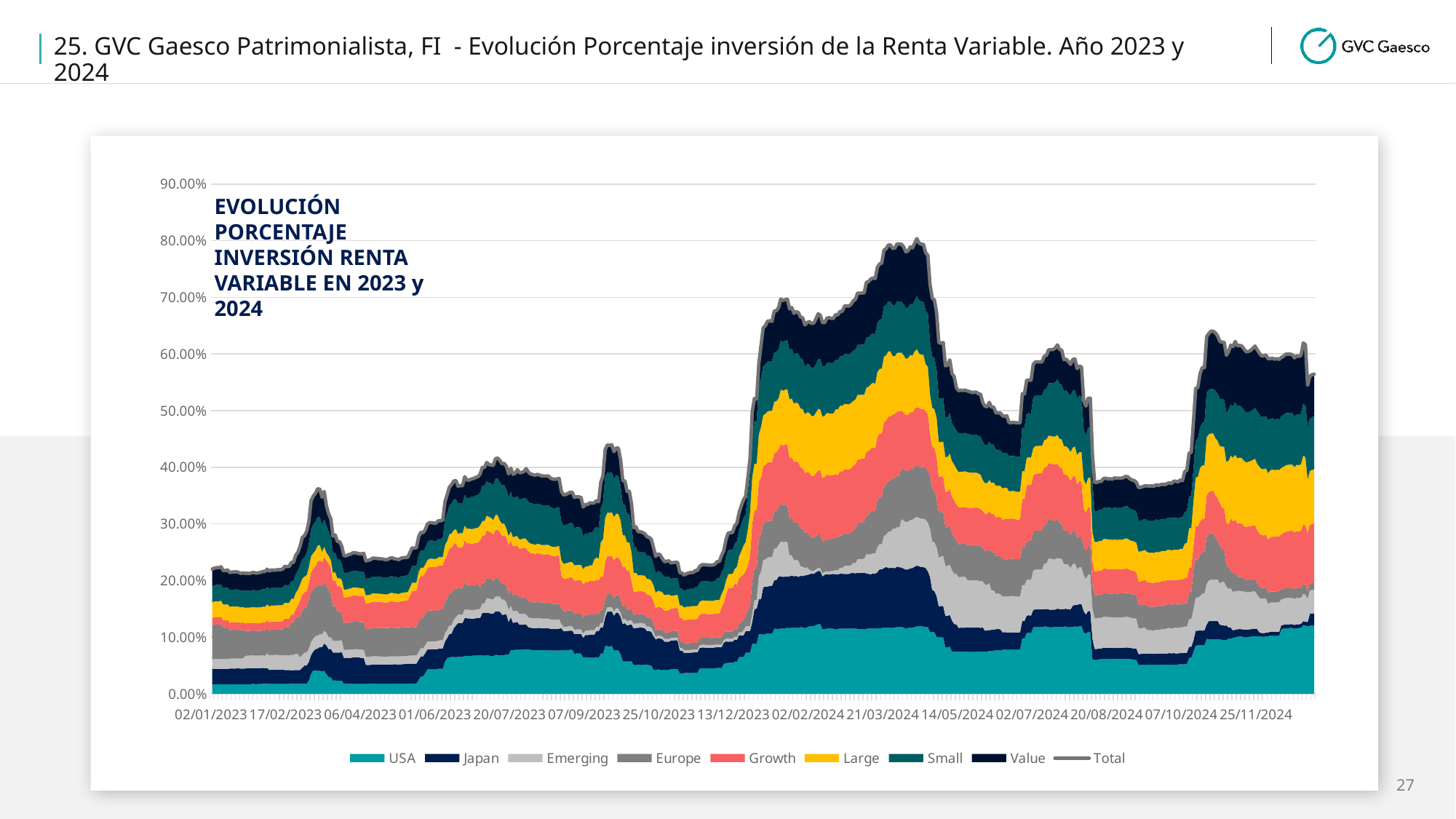
Which legend entry is drawn as a line rather than a filled area? Total Is the Total value at 02/01/2023 greater or less than 30%? less How many date labels are shown on the horizontal axis? 15 Is the Total value at 13/12/2023 greater or less than 30%? less What is the title printed inside the chart area? EVOLUCIÓN PORCENTAJE INVERSIÓN RENTA VARIABLE EN 2023 y 2024 Is the highest point of the Total line greater or less than 70%? greater How many series does the legend list? 9 What kind of chart is shown on the slide? Stacked area chart What is the highest value shown on the vertical axis? 90.00% Does the Total line end higher or lower at the right edge of the chart than it starts at 02/01/2023? higher